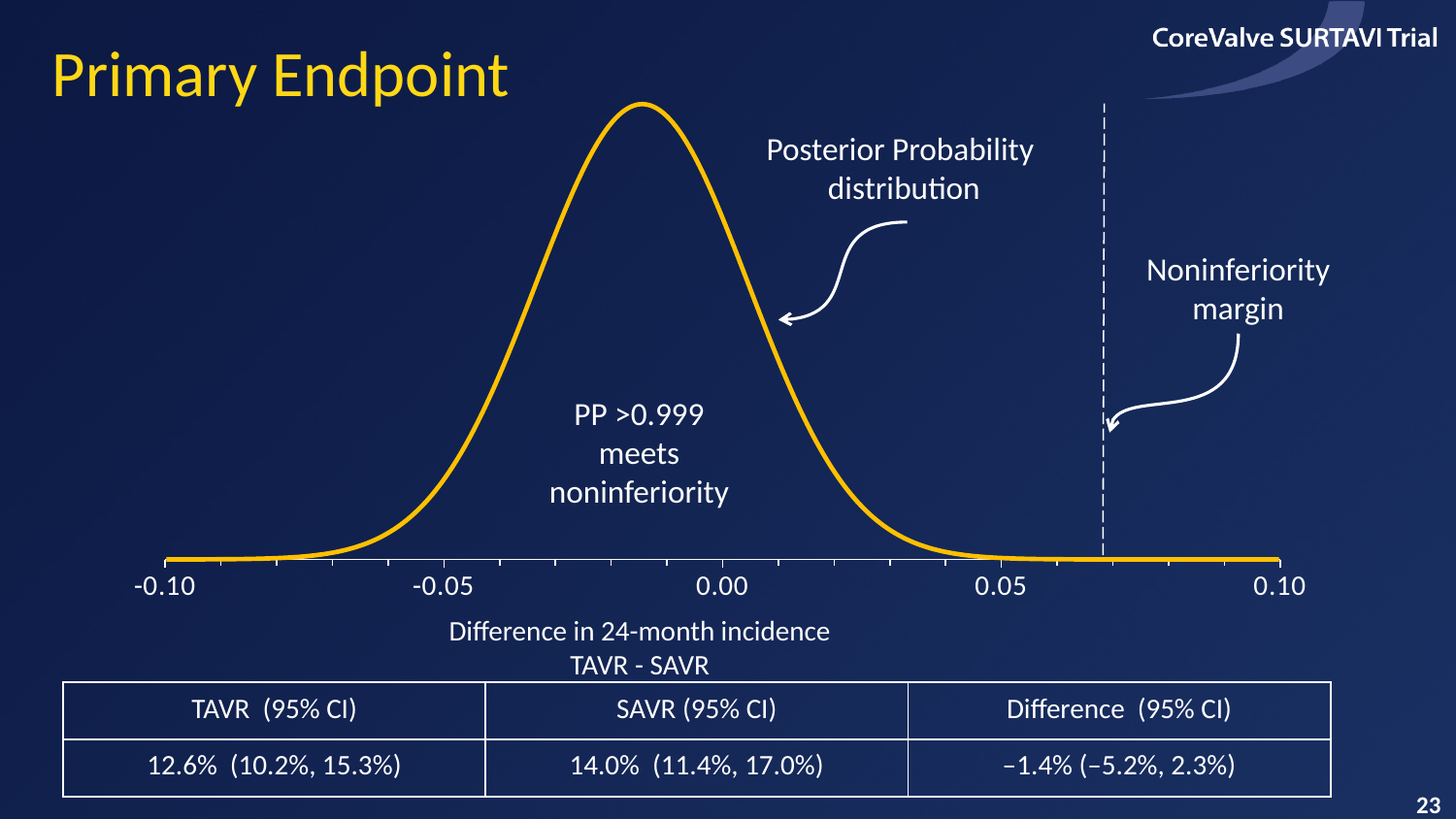
What is the highest value labeled on the x axis? 0.10 What kind of chart is shown on the slide? Line chart (a probability distribution curve) What is the difference (TAVR - SAVR) in 24-month incidence shown in the table? −1.4% What is the 24-month incidence for TAVR shown in the table? 12.6% Is the noninferiority margin (dashed line) located at a value greater or less than 0.05 on the x axis? greater Is the peak of the posterior probability distribution at a value greater or less than 0.00 on the x axis? less Which has the higher 24-month incidence in the table, TAVR or SAVR? SAVR What is the x-axis label of the chart? Difference in 24-month incidence TAVR - SAVR What posterior probability (PP) is stated on the chart for meeting noninferiority? >0.999 How many tick values are labeled on the x axis? 5 What is the title of the slide containing the chart? Primary Endpoint What is the lowest value labeled on the x axis? -0.10